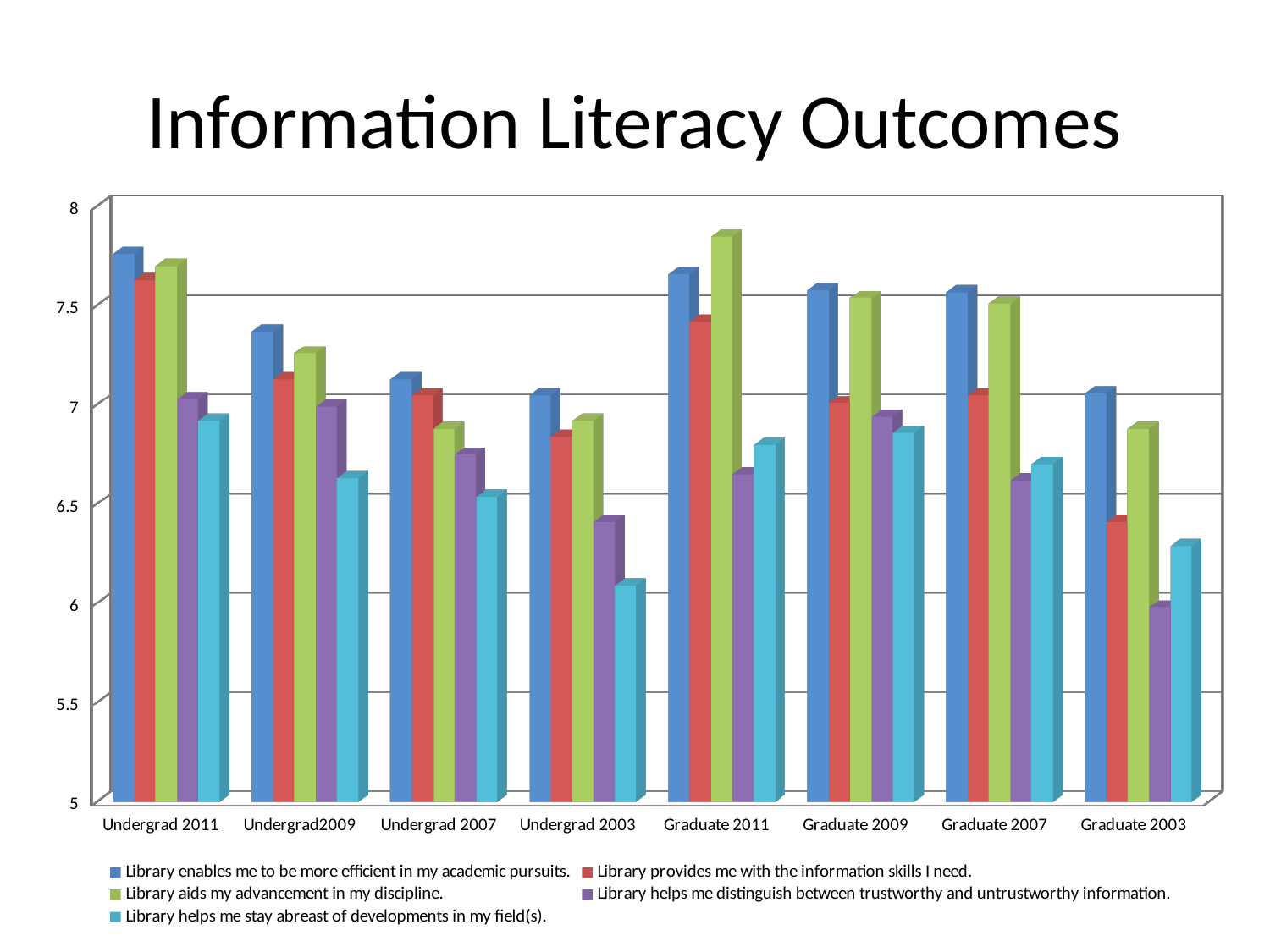
Is the value for 'Library helps me stay abreast of developments in my field(s).' for Undergrad 2003 greater or less than 6.5? less What is the title of the chart? Information Literacy Outcomes Is the value for 'Library provides me with the information skills I need.' for Graduate 2003 greater or less than 6.5? less Is the value for 'Library enables me to be more efficient in my academic pursuits.' for Undergrad2009 greater or less than 7? greater Which category has the lowest value for 'Library helps me distinguish between trustworthy and untrustworthy information.'? Graduate 2003 Which category has the lowest value for 'Library helps me stay abreast of developments in my field(s).'? Undergrad 2003 How many series does the legend list? 5 How many categories are shown along the x axis? 8 For Graduate 2011, which is larger: 'Library aids my advancement in my discipline.' or 'Library enables me to be more efficient in my academic pursuits.'? Library aids my advancement in my discipline. What kind of chart is shown on the slide? bar chart Which category has the highest value for 'Library aids my advancement in my discipline.'? Graduate 2011